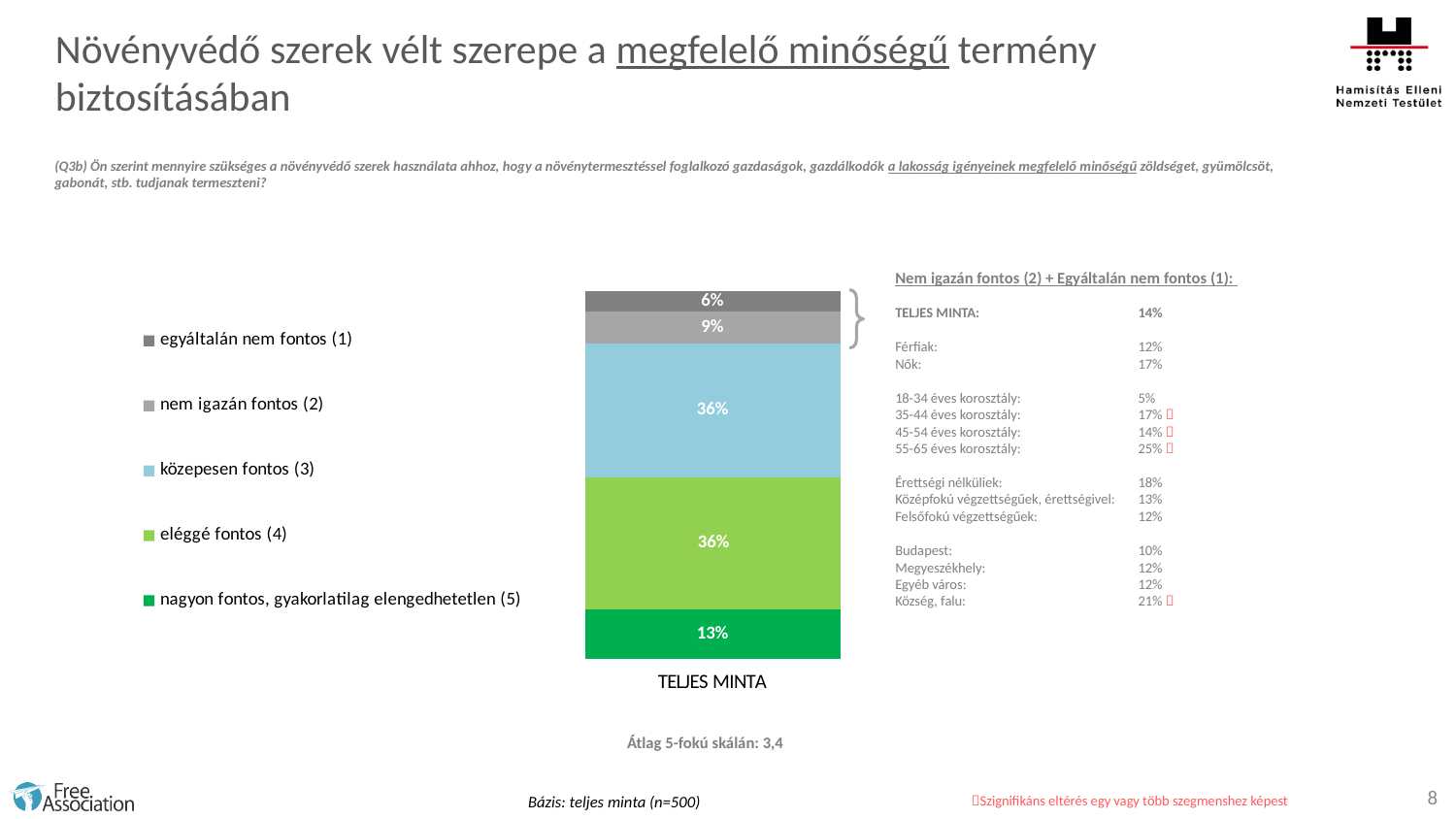
Which is larger: the "nagyon fontos, gyakorlatilag elengedhetetlen (5)" segment or the "egyáltalán nem fontos (1)" segment? nagyon fontos, gyakorlatilag elengedhetetlen (5) How many series does the chart legend list? 5 What is the label of the single category on the chart's x axis? TELJES MINTA What percentage of the TELJES MINTA bar is labelled "közepesen fontos (3)"? 36% What is the difference between the "nagyon fontos, gyakorlatilag elengedhetetlen (5)" segment and the "nem igazán fontos (2)" segment? 4% What value is shown for "egyáltalán nem fontos (1)" in the stacked bar? 6% What value is shown for "nagyon fontos, gyakorlatilag elengedhetetlen (5)" in the stacked bar? 13% What is the total of all segments in the TELJES MINTA stacked bar? 100% What type of chart is shown on the slide? stacked bar chart What value is shown for "nem igazán fontos (2)" in the stacked bar? 9% How many bars are plotted in the chart? 1 Which segment of the stacked bar has the smallest value? egyáltalán nem fontos (1)